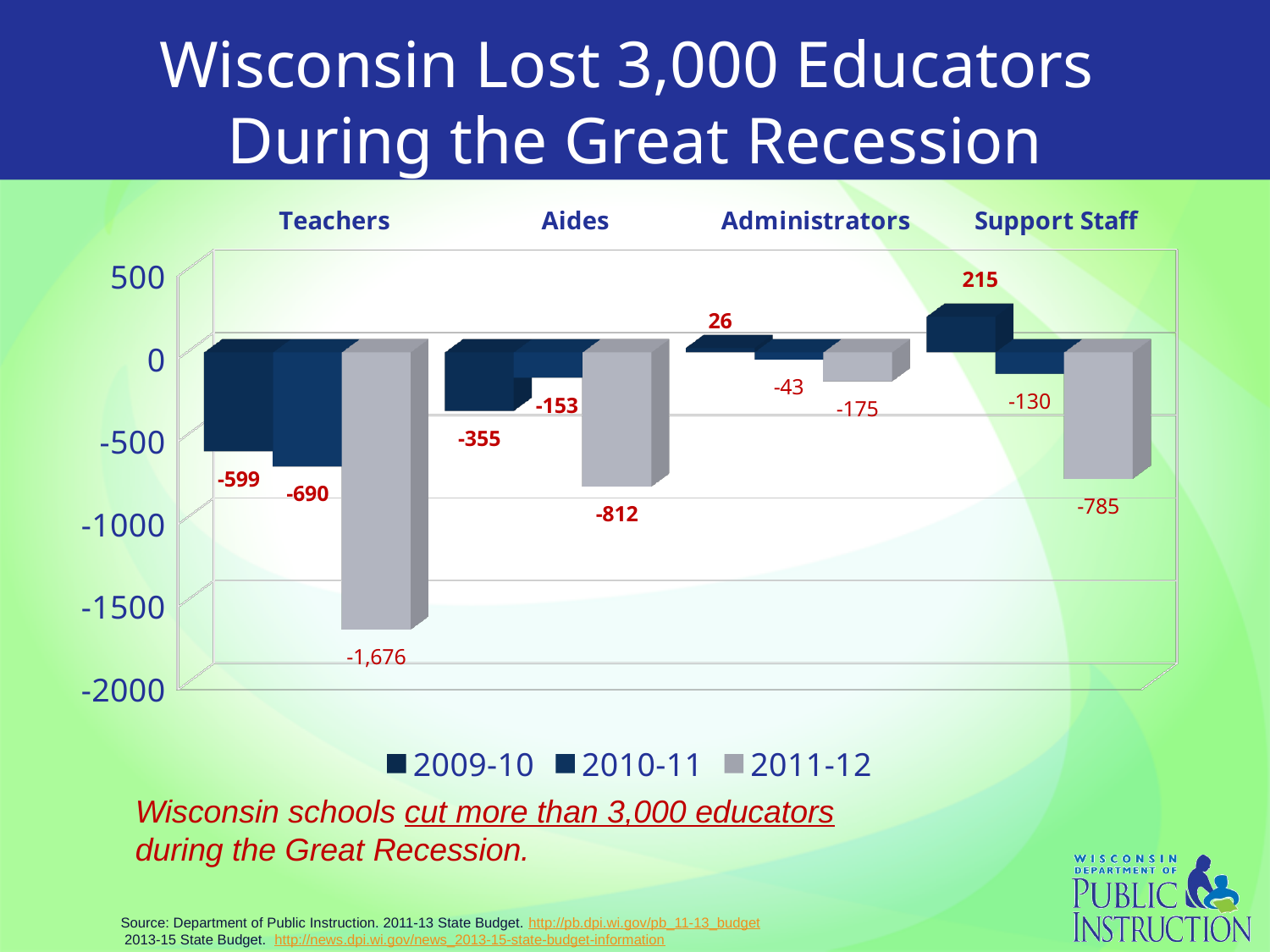
What is the value for Aides in 2010-11? -153 What is the title of the slide? Wisconsin Lost 3,000 Educators During the Great Recession What is the value for Teachers in 2011-12? -1,676 What is the value for Support Staff in 2009-10? 215 Which category has the highest value in 2009-10? Support Staff What is the value for Administrators in 2011-12? -175 How many series does the legend list? 3 What is the difference between the Teachers values for 2010-11 and 2009-10? 91 What kind of chart is shown on the slide? Bar chart Which category has the lowest value in 2011-12? Teachers How many categories are shown on the x axis? 4 Which is larger, the Aides value for 2011-12 or the Support Staff value for 2011-12? Support Staff (-785)